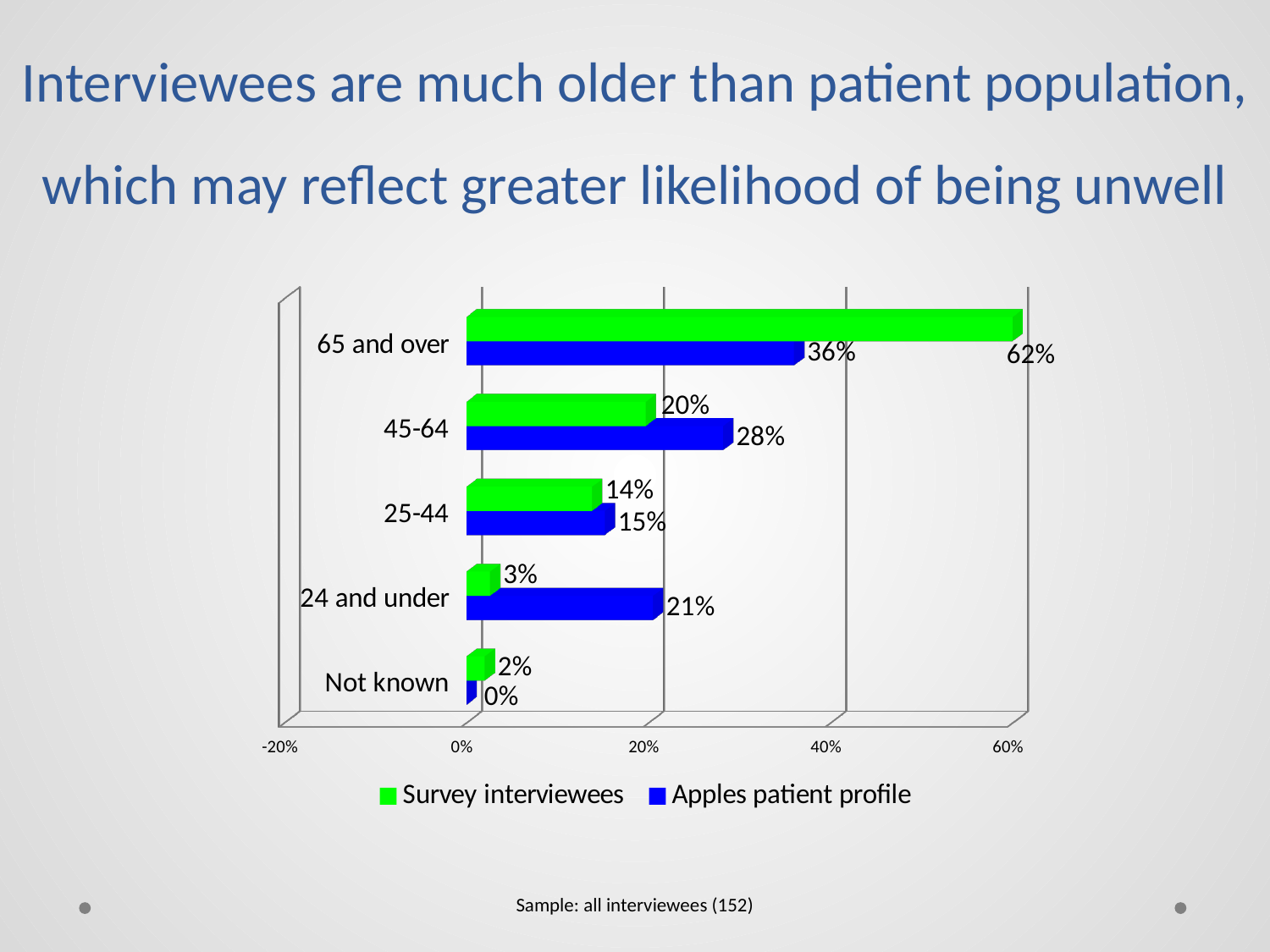
What percentage of survey interviewees are aged 65 and over? 62% What is the Apples patient profile value for the 24 and under age group? 21% What type of chart is shown on the slide? Bar chart What colour represents the survey interviewees series? Green Which age group has the highest value for survey interviewees? 65 and over What is the difference between survey interviewees and the Apples patient profile for the 65 and over group? 26 percentage points What is the survey interviewees value for the 25-44 age group? 14% Which category has the lowest value for the Apples patient profile? Not known How many age categories are shown on the chart? 5 How many series does the legend list? 2 For the 24 and under group, which is larger: survey interviewees or Apples patient profile? Apples patient profile What is the Apples patient profile value for the 45-64 age group? 28%